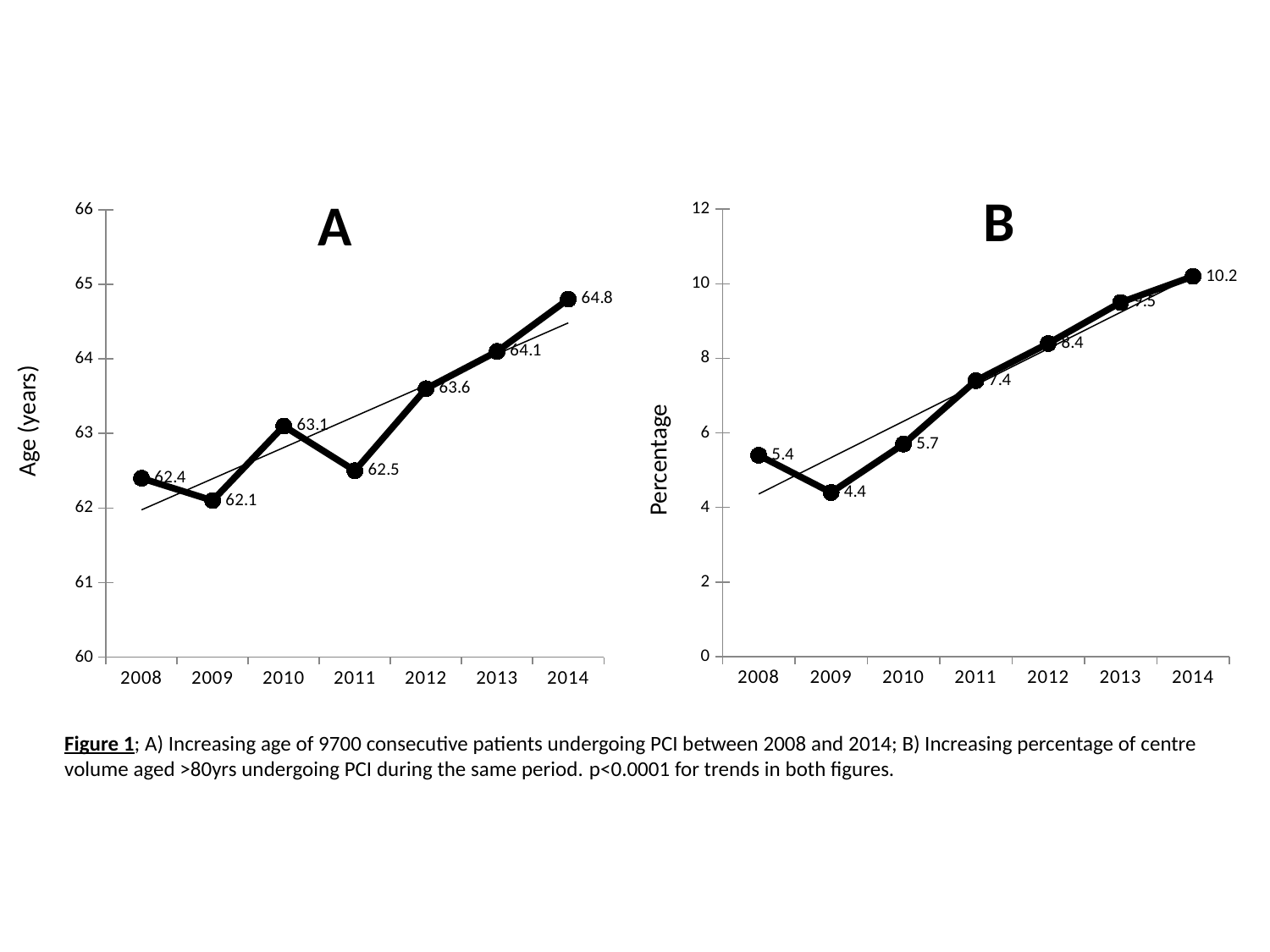
In chart A, which is larger, the value for 2010 or the value for 2011? 2010 What kind of chart is chart A? line chart In chart B, is the value for 2013 greater or less than 8? greater In chart A, what is the value for 2009? 62.1 In chart B, what is the value for 2014? 10.2 In chart A, which year has the lowest value? 2009 In chart B, which year has the highest value? 2014 In chart B, what is the difference between the values for 2012 and 2009? 4 In chart A, what is the value for 2014? 64.8 In chart A, what is the difference between the values for 2014 and 2008? 2.4 In chart B, what is the value for 2011? 7.4 How many years are plotted in chart B? 7